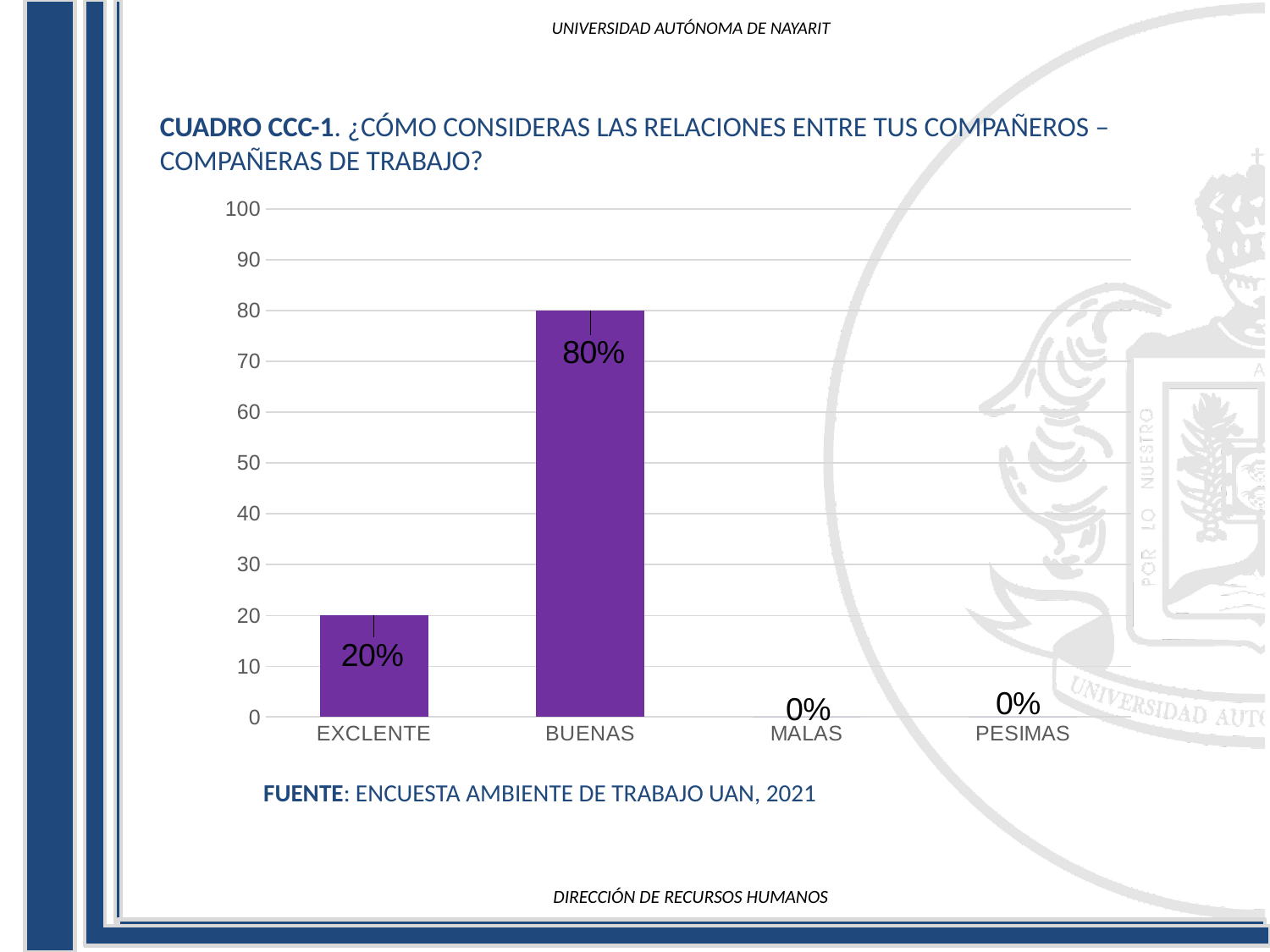
What is the difference between the values for BUENAS and EXCLENTE? 60% What is the value for BUENAS? 80% How many categories are shown on the x axis? 4 What is the value for EXCLENTE? 20% Is the value for BUENAS greater or less than 50? greater What is the value for MALAS? 0% Which category has the highest value? BUENAS What is the source cited below the chart? ENCUESTA AMBIENTE DE TRABAJO UAN, 2021 What is the value for PESIMAS? 0% Which is larger, the value for EXCLENTE or the value for BUENAS? BUENAS What kind of chart is shown on the slide? bar chart Is the value for EXCLENTE greater or less than 30? less